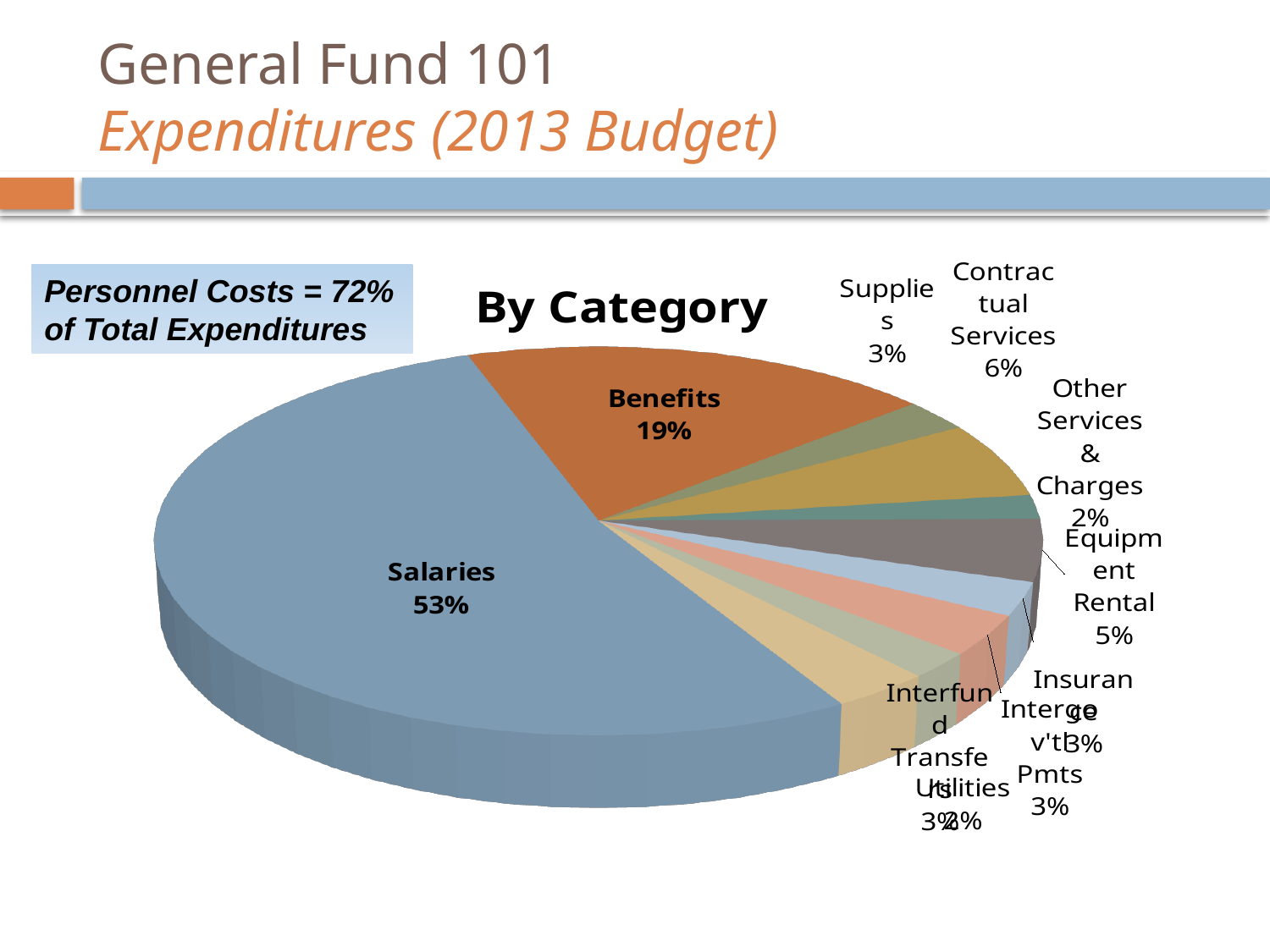
What is the difference in percentage points between Salaries and Benefits? 34% Which category has the largest share of the pie? Salaries How many slices does the pie chart have? 10 What percentage is shown for Contractual Services? 6% What share of the pie is Benefits? 19% What percentage is shown for Supplies? 3% What share of the pie is Salaries? 53% What percentage is shown for Other Services & Charges? 2% What is the title of the chart? By Category What percentage is shown for Equipment Rental? 5% Which is larger, the share for Contractual Services or the share for Equipment Rental? Contractual Services What kind of chart is shown on the slide? pie chart